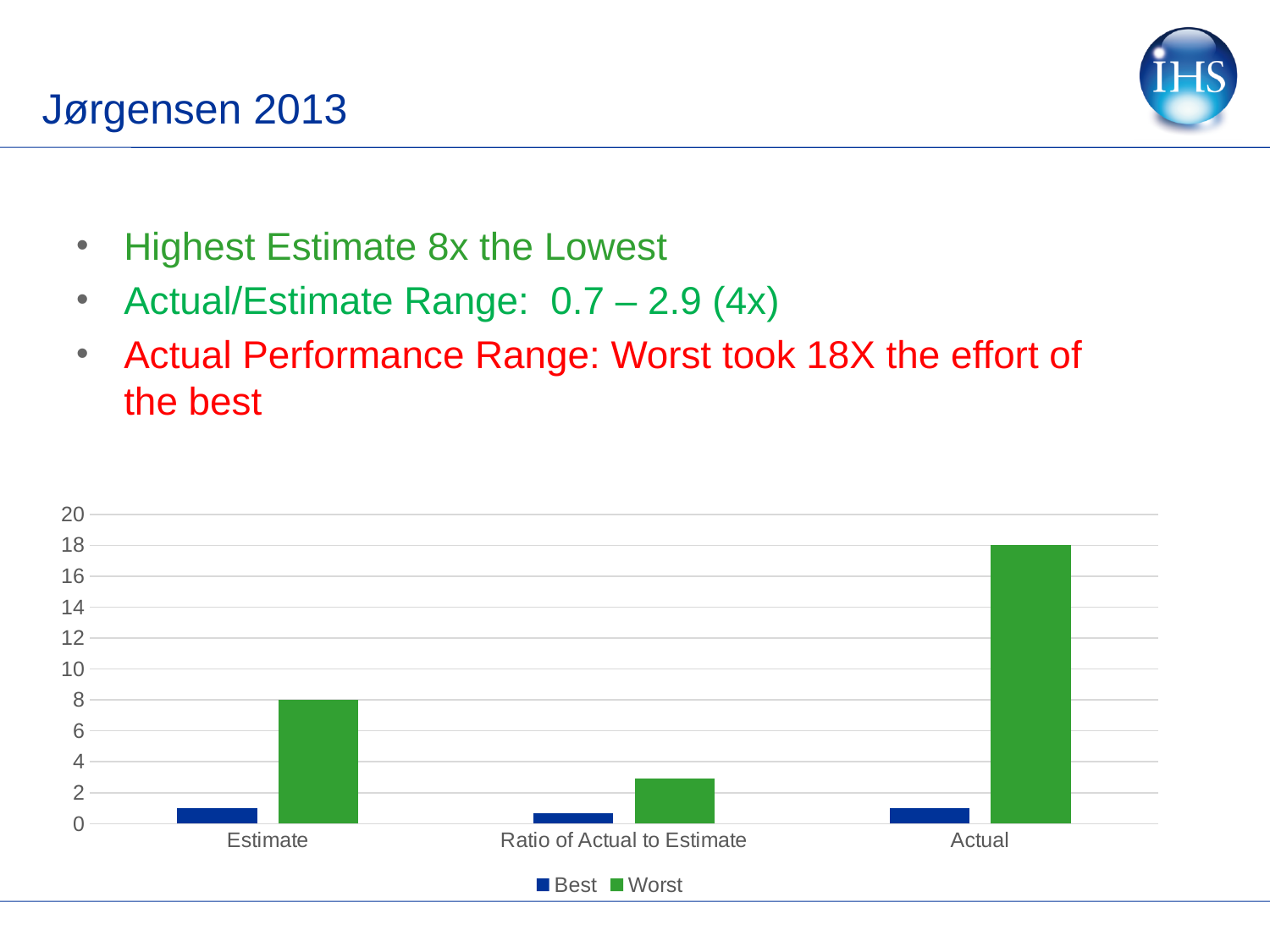
How many series does the chart legend list? 2 What kind of chart is shown on the slide? bar chart How many categories are shown on the x axis of the chart? 3 Which category has the highest Worst value? Actual Which is larger, the Worst value for Actual or the Worst value for Estimate? Worst value for Actual Which category has the lowest Worst value? Ratio of Actual to Estimate What is the difference between the Worst value for Actual and the Worst value for Estimate? 10 Is the Worst value for Ratio of Actual to Estimate greater or less than 4? less What is the Worst value for Estimate? 8 What is the Worst value for Actual? 18 Is the Best value for Estimate greater or less than 2? less Which series is shown in green in the chart? Worst